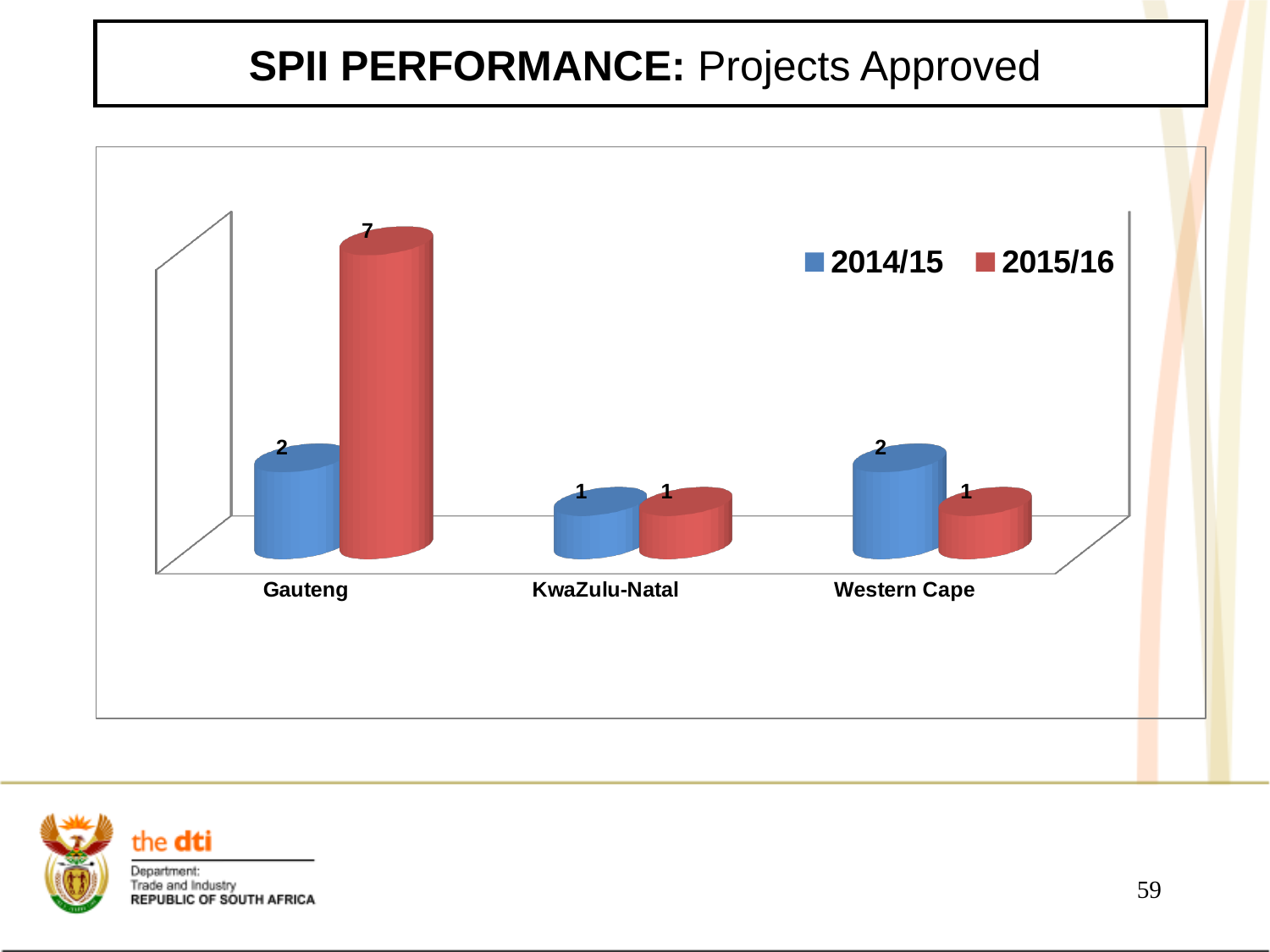
How many provinces are shown on the x axis? 3 What kind of chart is shown on the slide? Bar chart Which is larger for Western Cape: the 2014/15 value or the 2015/16 value? 2014/15 How many projects were approved in Gauteng in 2015/16? 7 How many projects were approved in Gauteng in 2014/15? 2 What is the difference between the 2015/16 and 2014/15 values for Gauteng? 5 Which province has the lowest number of projects approved in 2014/15? KwaZulu-Natal What is the value for Western Cape in 2015/16? 1 Which province has the highest number of projects approved in 2015/16? Gauteng How many series does the legend list? 2 What is the value for KwaZulu-Natal in 2014/15? 1 Which colour represents the 2015/16 series? Red